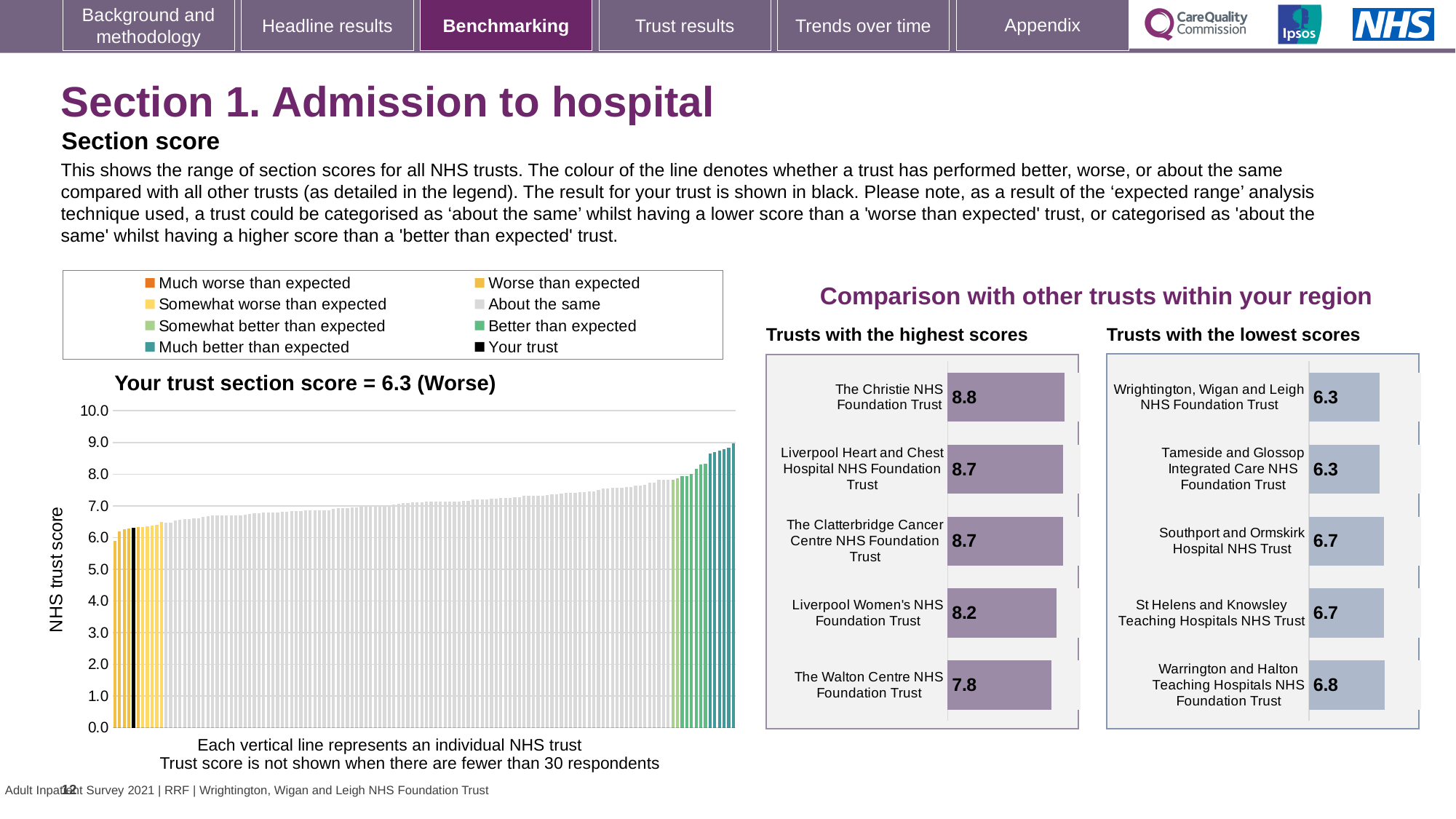
In the 'Trusts with the highest scores' chart, what is the difference between the scores of The Christie NHS Foundation Trust and Liverpool Women's NHS Foundation Trust? 0.6 In the 'Trusts with the highest scores' chart, what is the score for The Christie NHS Foundation Trust? 8.8 In the 'Trusts with the highest scores' chart, what is the score for The Walton Centre NHS Foundation Trust? 7.8 What kind of chart is the 'Your trust section score' chart on the left? bar chart In the 'Trusts with the lowest scores' chart, what is the difference between the scores of Warrington and Halton Teaching Hospitals NHS Foundation Trust and Wrightington, Wigan and Leigh NHS Foundation Trust? 0.5 In the 'Your trust section score' chart on the left, do the trust scores rise or fall from left to right? rise In the 'Trusts with the lowest scores' chart, is the score for Warrington and Halton Teaching Hospitals NHS Foundation Trust larger or smaller than the score for Tameside and Glossop Integrated Care NHS Foundation Trust? larger In the 'Trusts with the lowest scores' chart, what is the score for Southport and Ormskirk Hospital NHS Trust? 6.7 In the 'Trusts with the lowest scores' chart, which trust has the highest score? Warrington and Halton Teaching Hospitals NHS Foundation Trust In the 'Trusts with the highest scores' chart, which trust has the lowest score? The Walton Centre NHS Foundation Trust In the 'Trusts with the lowest scores' chart, how many trusts are shown? 5 In the 'Your trust section score' chart on the left, what is the section score for your trust? 6.3